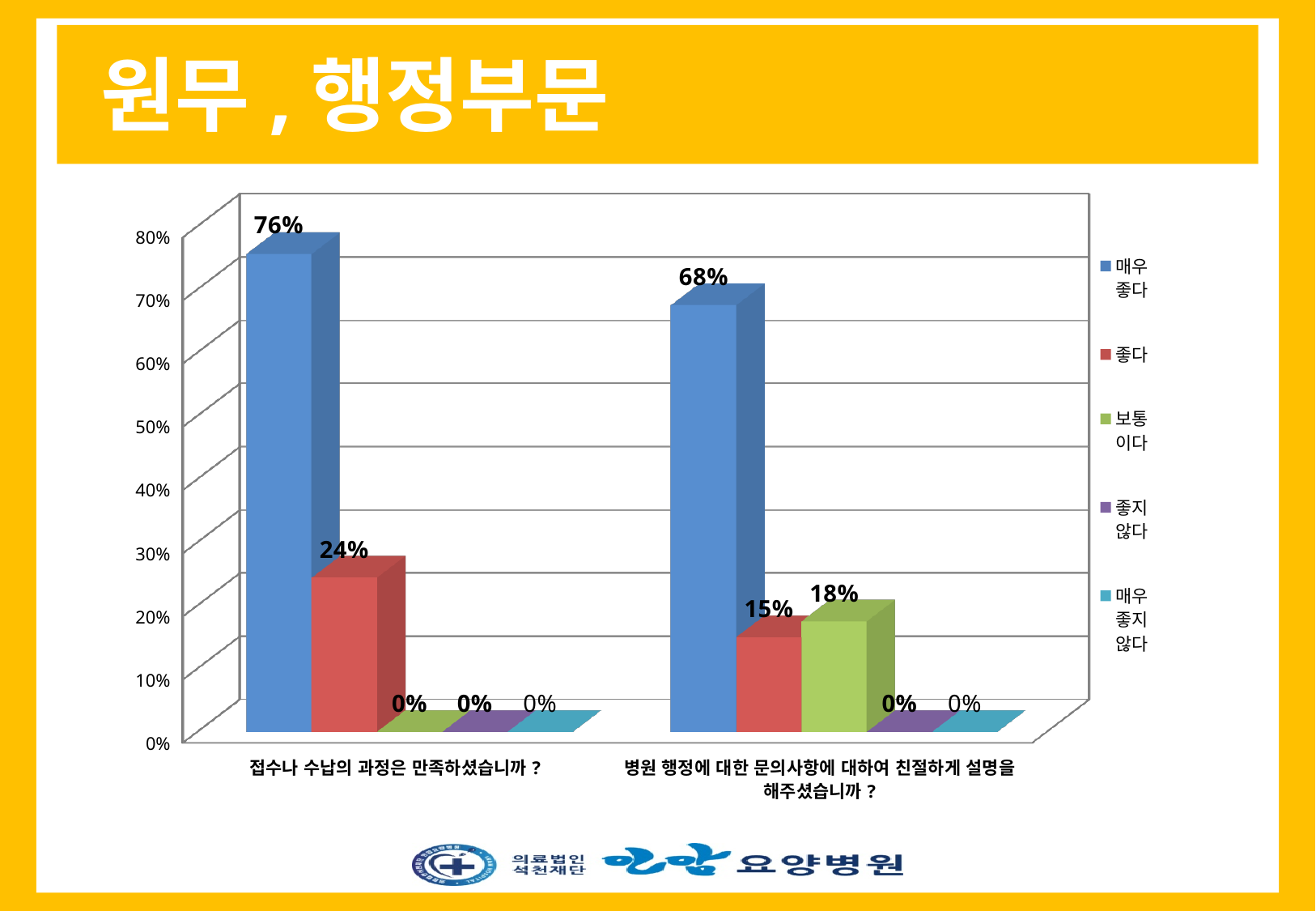
What is the value for 보통이다 for the question 병원 행정에 대한 문의사항에 대하여 친절하게 설명을 해주셨습니까? 18% Which series has the highest value for the question 접수나 수납의 과정은 만족하셨습니까? 매우 좋다 What is the value for 매우 좋다 for the question 접수나 수납의 과정은 만족하셨습니까? 76% What is the title of the slide? 원무 , 행정부문 How many categories (questions) are shown on the x axis? 2 What is the value for 좋다 for the question 접수나 수납의 과정은 만족하셨습니까? 24% What kind of chart is shown on the slide? bar chart How many series does the legend list? 5 What is the value for 좋다 for the question 병원 행정에 대한 문의사항에 대하여 친절하게 설명을 해주셨습니까? 15% What is the difference between the 매우 좋다 values for the two questions? 8% What is the value for 매우 좋다 for the question 병원 행정에 대한 문의사항에 대하여 친절하게 설명을 해주셨습니까? 68% For the question 병원 행정에 대한 문의사항에 대하여 친절하게 설명을 해주셨습니까?, which is larger: 좋다 or 보통이다? 보통이다